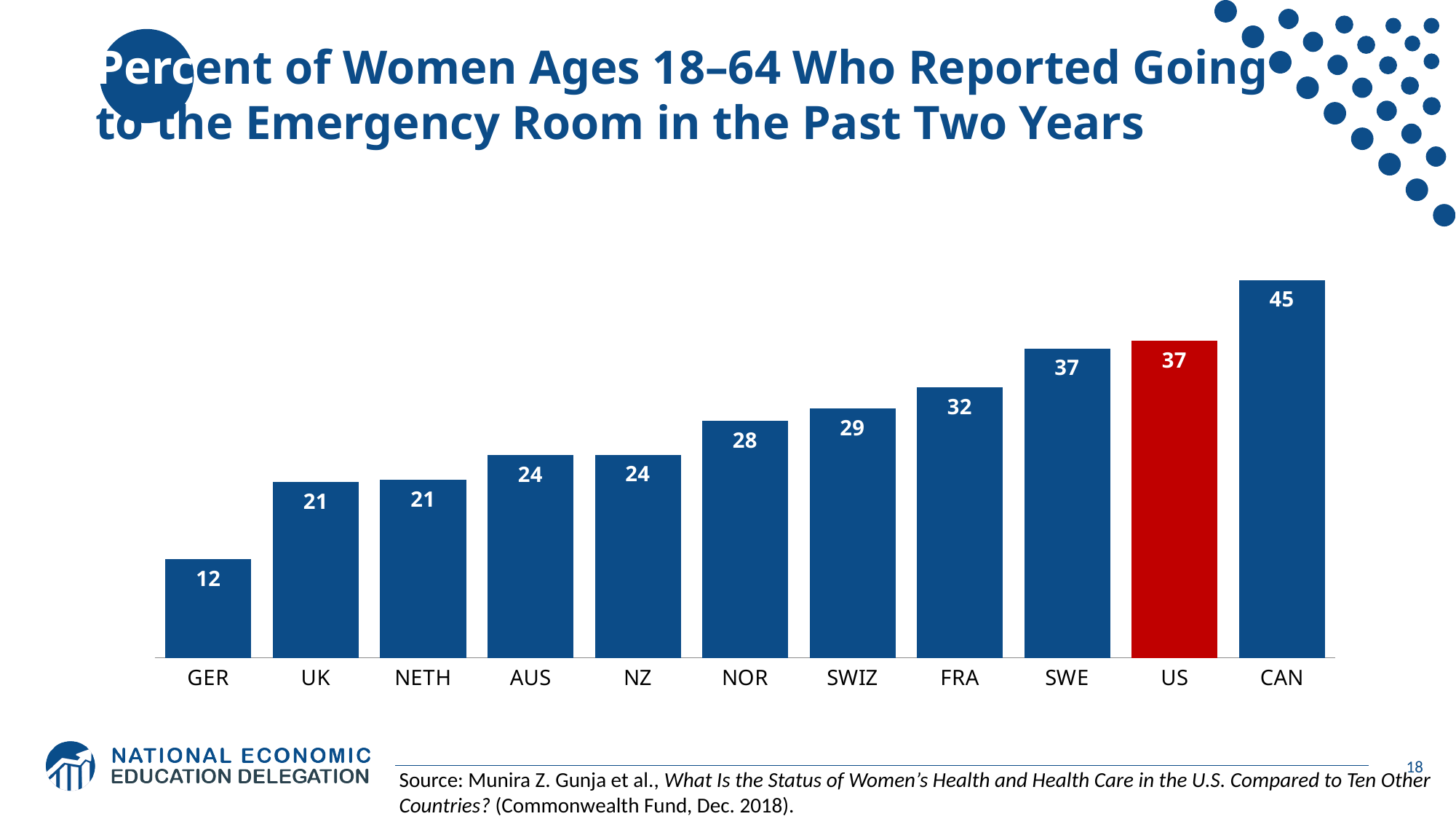
What is the value for NOR? 28 What is the difference between the values for CAN and the US? 8 Which country has the highest value? CAN Do the values rise or fall from left to right across the chart? Rise How many countries are shown on the chart? 11 What is the difference between the values for FRA and UK? 11 What is the value for GER? 12 Which country has the lowest value? GER Which is larger, the value for SWIZ or the value for AUS? SWIZ What is the value for the US? 37 Which bar is coloured red instead of blue? US What kind of chart is shown on the slide? Bar chart